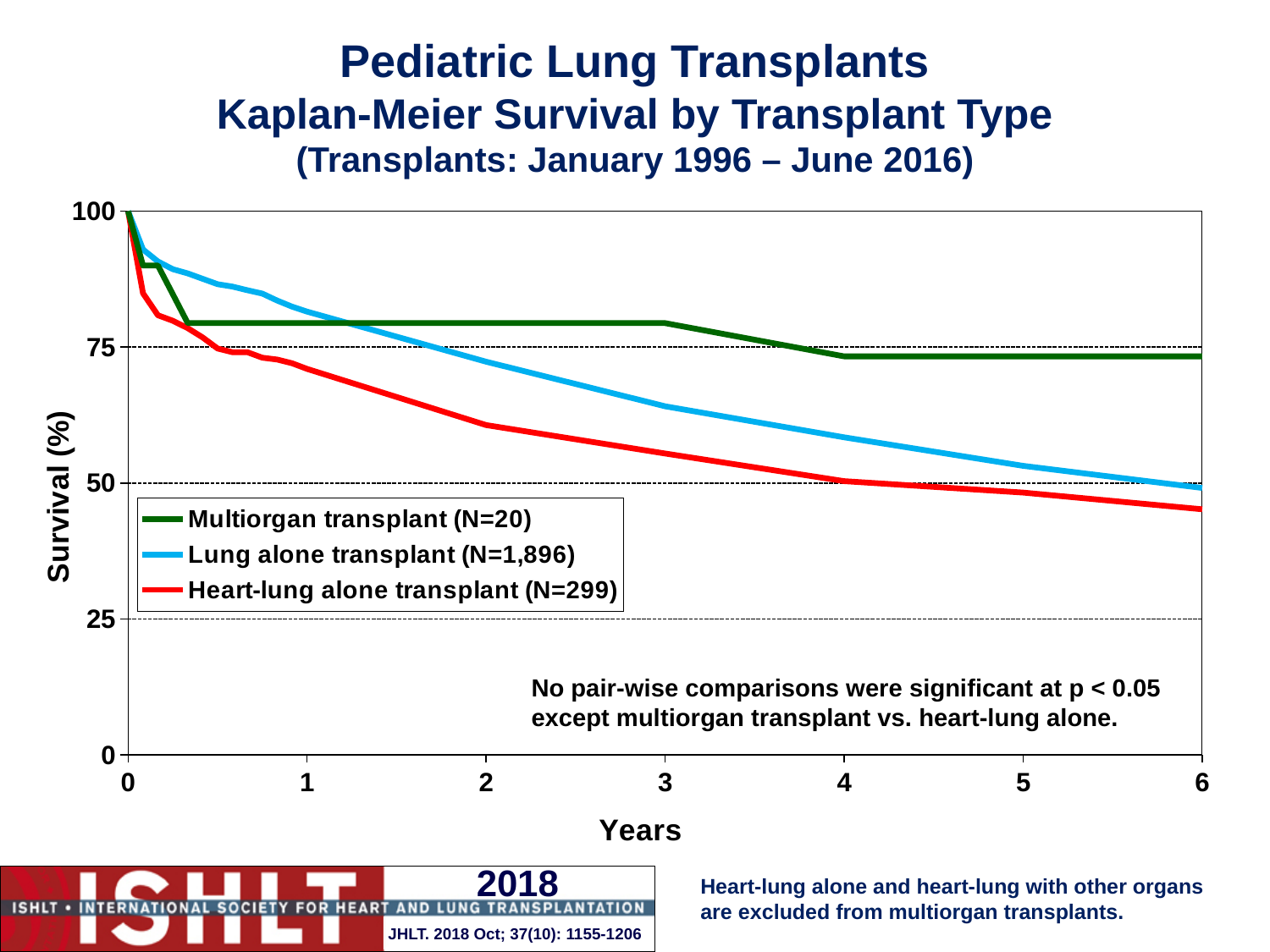
At 6 years, which transplant type has the lowest survival? Heart-lung alone transplant According to the legend, how many patients (N) are in the lung alone transplant group? 1,896 Is the survival value for lung alone transplant at 4 years greater or less than 50? greater Is the survival value for multiorgan transplant at 2 years greater or less than 75? greater Is the survival value for heart-lung alone transplant at 2 years greater or less than 50? greater What kind of chart is shown on the slide? Line chart At 5 years, which has higher survival: lung alone transplant or heart-lung alone transplant? Lung alone transplant How many series does the legend list? 3 Do the survival curves rise or fall as years increase? Fall At 6 years, which transplant type has the highest survival? Multiorgan transplant